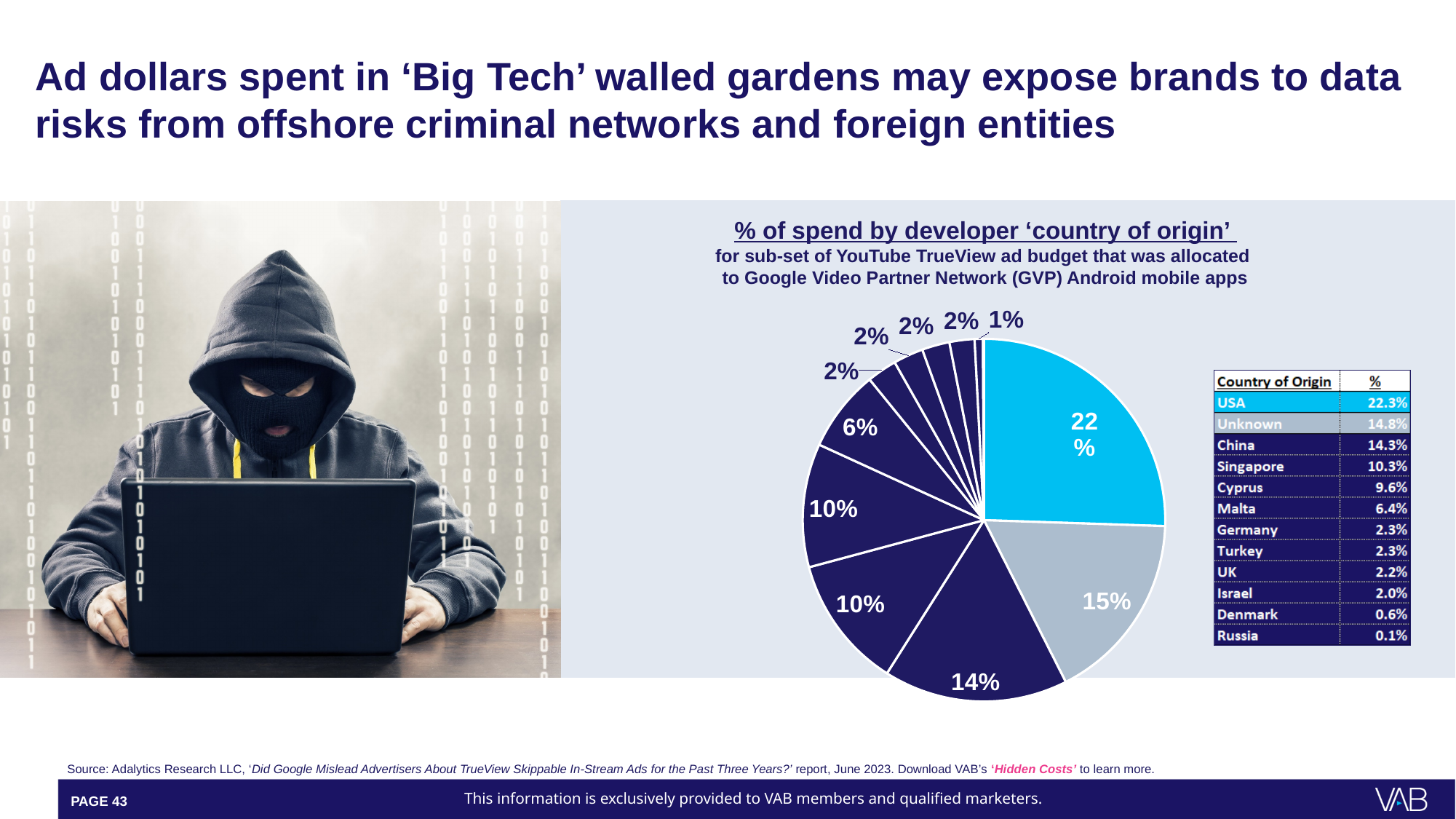
What percentage of spend is attributed to an 'Unknown' country of origin in the table? 14.8% What is the title of the chart? % of spend by developer 'country of origin' What percentage of spend is attributed to China in the table? 14.3% What percentage of spend is attributed to Malta in the table? 6.4% What percentage of spend is attributed to Cyprus in the table? 9.6% Which country of origin has the smallest share of spend according to the table next to the pie chart? Russia What kind of chart is shown on the slide? Pie chart Which country of origin has the largest share of spend in the pie chart? USA Which has a larger share of spend, Cyprus or Malta? Cyprus How many countries of origin are listed in the table beside the pie chart? 12 What is the difference in percentage points between China's share and Singapore's share in the table? 4.0 percentage points What percentage of spend is attributed to the USA in the table? 22.3%